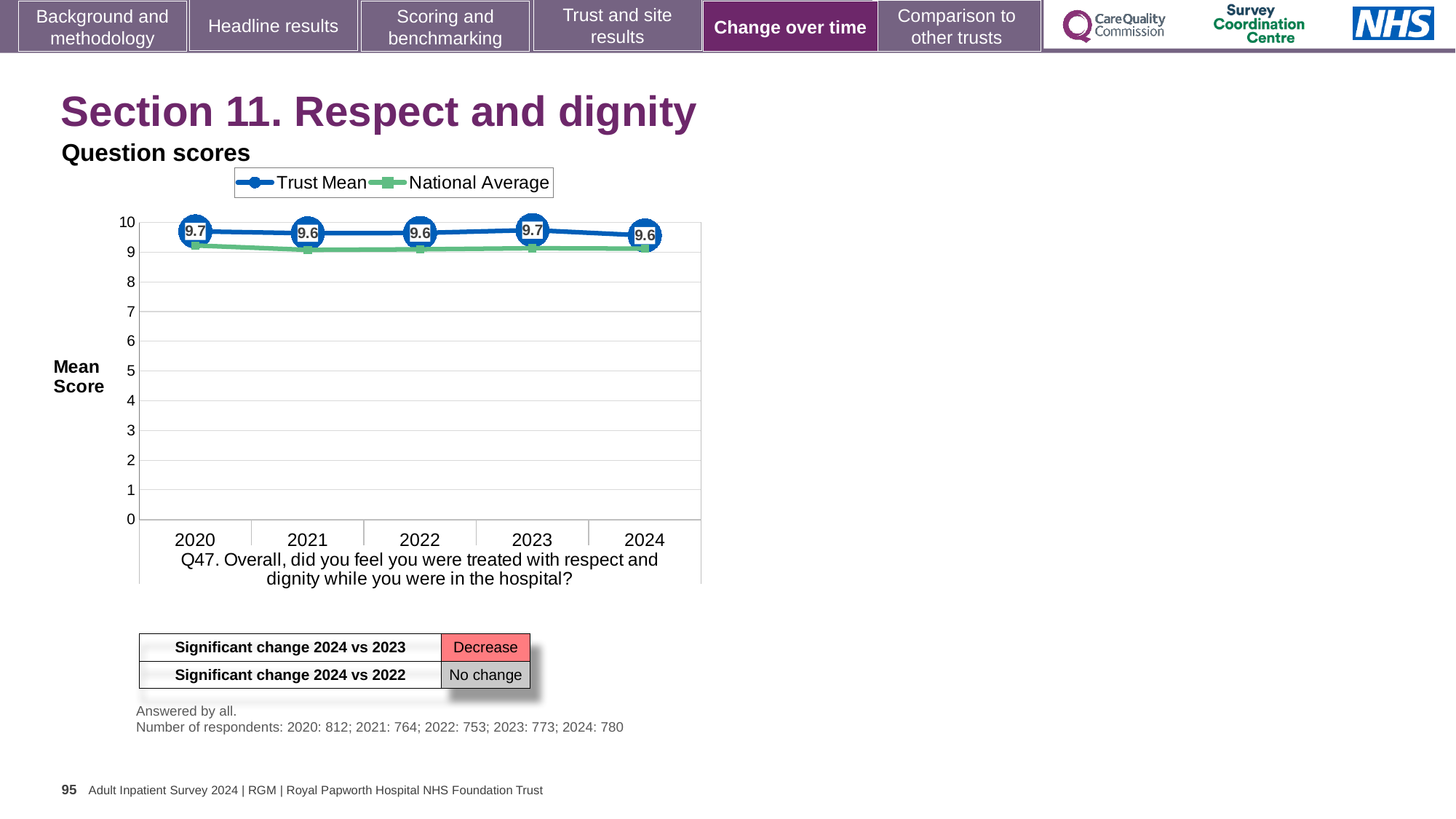
What is the difference between the Trust Mean scores for 2020 and 2021? 0.1 What is the Trust Mean score for 2023? 9.7 What is the Trust Mean score for 2020? 9.7 What kind of chart is shown? Line chart What is the label on the y axis? Mean Score In 2020, which is higher: the Trust Mean or the National Average? Trust Mean What is the Trust Mean score for 2021? 9.6 How many years are plotted on the x axis? 5 Is the National Average value for 2021 greater or less than 8? greater How many series does the legend list? 2 What are the two series named in the legend? Trust Mean and National Average What is the Trust Mean score for 2024? 9.6